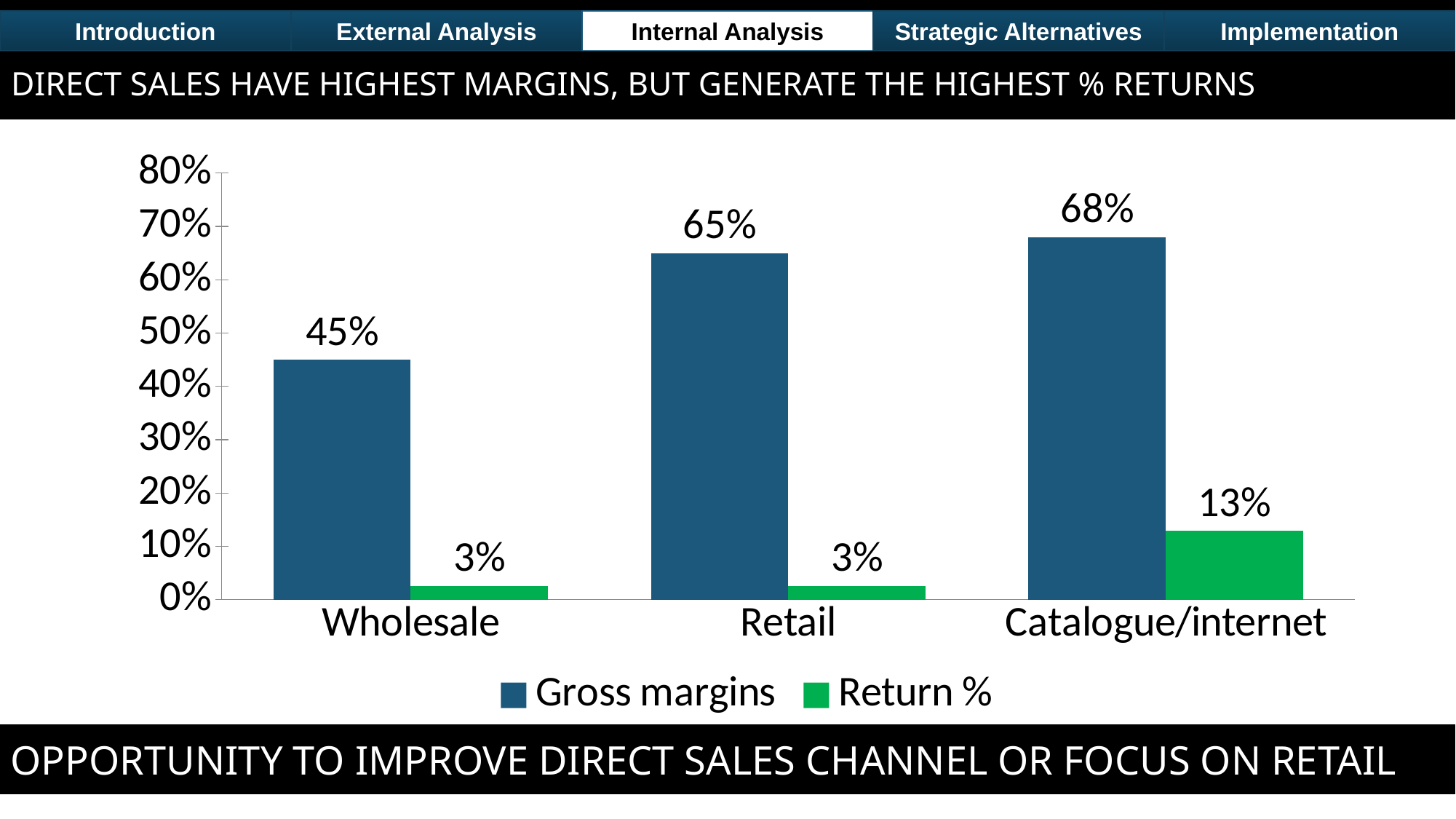
How many channels are shown on the x axis? 3 What is the gross margin for Retail? 65% What is the difference between the gross margins of Catalogue/internet and Wholesale? 23% What kind of chart is shown on the slide? Bar chart What is the difference between the Return % of Catalogue/internet and Retail? 10% Which channel has the lowest gross margin? Wholesale Which is larger, the gross margin for Retail or for Wholesale? Retail What is the gross margin for Wholesale? 45% Which channel has the highest gross margin? Catalogue/internet What is the Return % for Catalogue/internet? 13% Which colour represents Return % in the chart? Green How many series does the legend list? 2